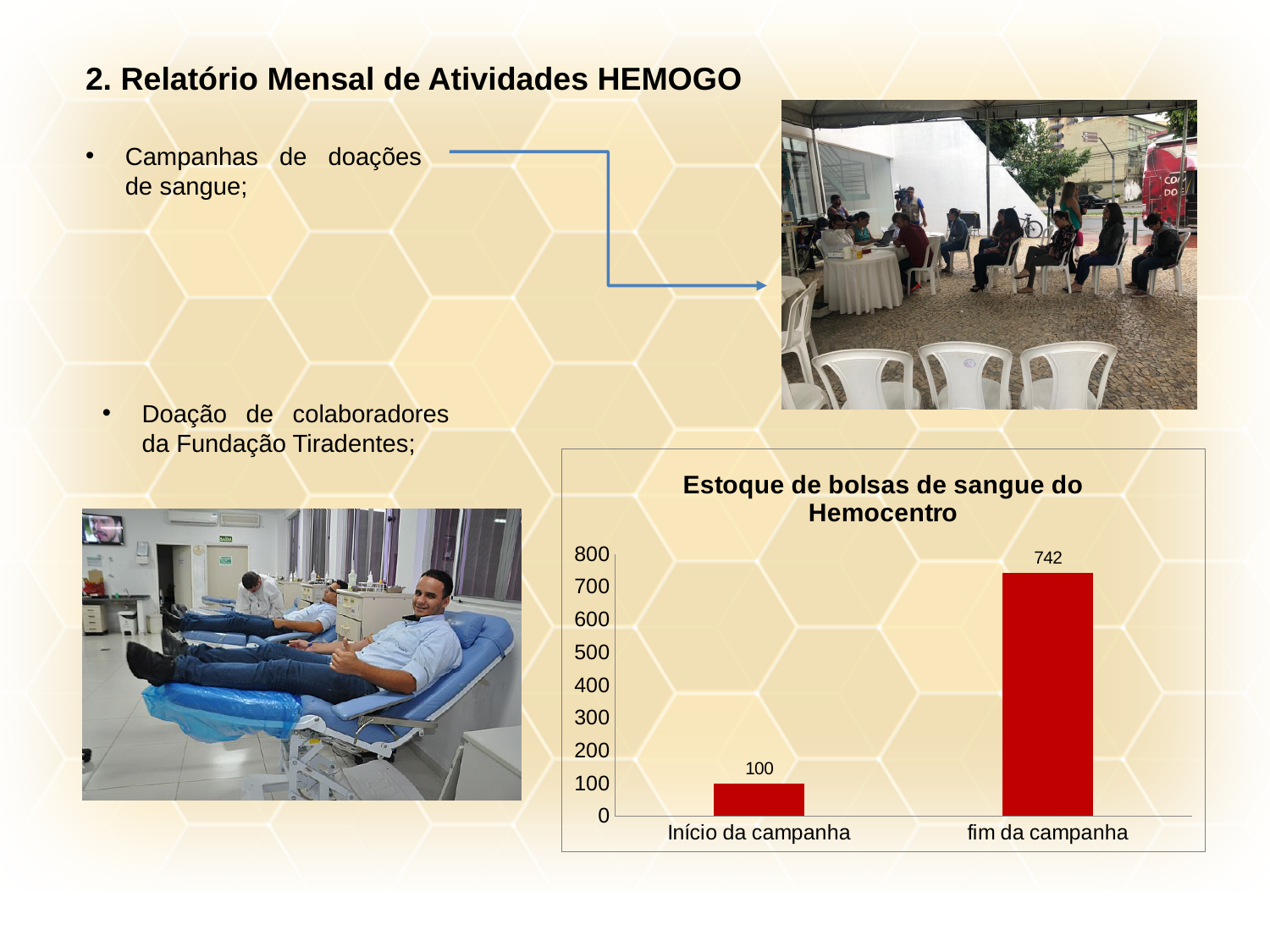
How many categories are shown on the x axis of the chart? 2 What kind of chart is shown on the slide? bar chart What is the value for "fim da campanha"? 742 What is the difference between the value at the end of the campaign and the value at the start of the campaign? 642 Is the value for "Início da campanha" greater or less than 200? less Which category has the highest value? fim da campanha What is the title of the chart? Estoque de bolsas de sangue do Hemocentro Do the values rise or fall from the start of the campaign to the end of the campaign? rise Which category has the lowest value? Início da campanha What is the value for "Início da campanha"? 100 Is the value for "fim da campanha" greater or less than 700? greater Which is larger, the value for "Início da campanha" or the value for "fim da campanha"? fim da campanha